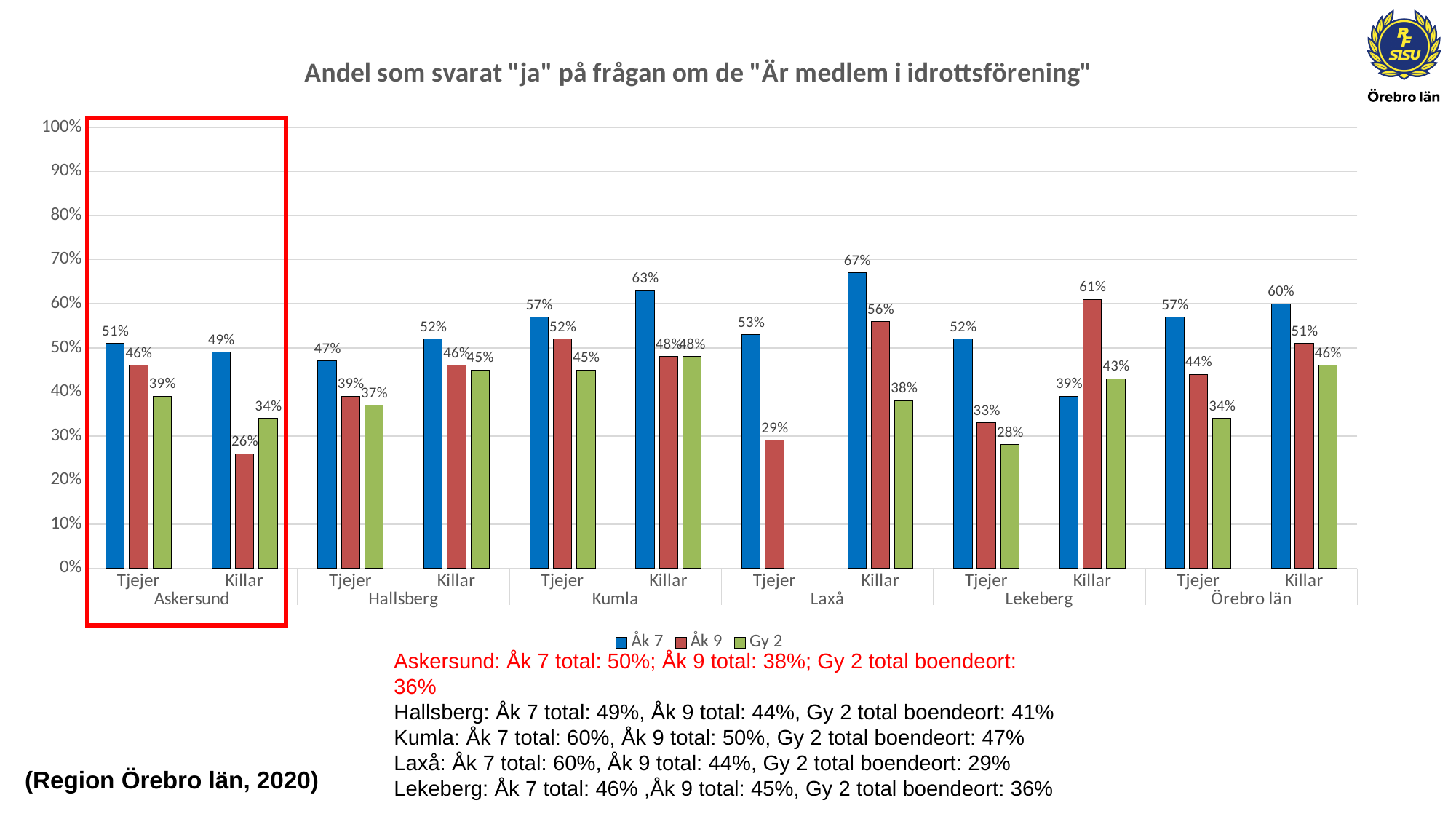
What is the title of the chart? Andel som svarat "ja" på frågan om de "Är medlem i idrottsförening" What is the Åk 9 value for Killar in Lekeberg? 61% Which is larger for Killar in Lekeberg: the Åk 7 value or the Åk 9 value? Åk 9 What is the difference between the Åk 7 values for Killar and Tjejer in Kumla? 6% Which group has the highest Åk 7 value in the chart? Killar, Laxå What is the Åk 9 value for Killar in Askersund? 26% Which group has the lowest Åk 9 value in the chart? Killar, Askersund What is the Åk 7 value for Tjejer in Askersund? 51% How many municipalities/regions are shown along the x axis? 6 What kind of chart is shown on the slide? Bar chart What is the Gy 2 value for Killar in Laxå? 38% How many series does the legend list? 3